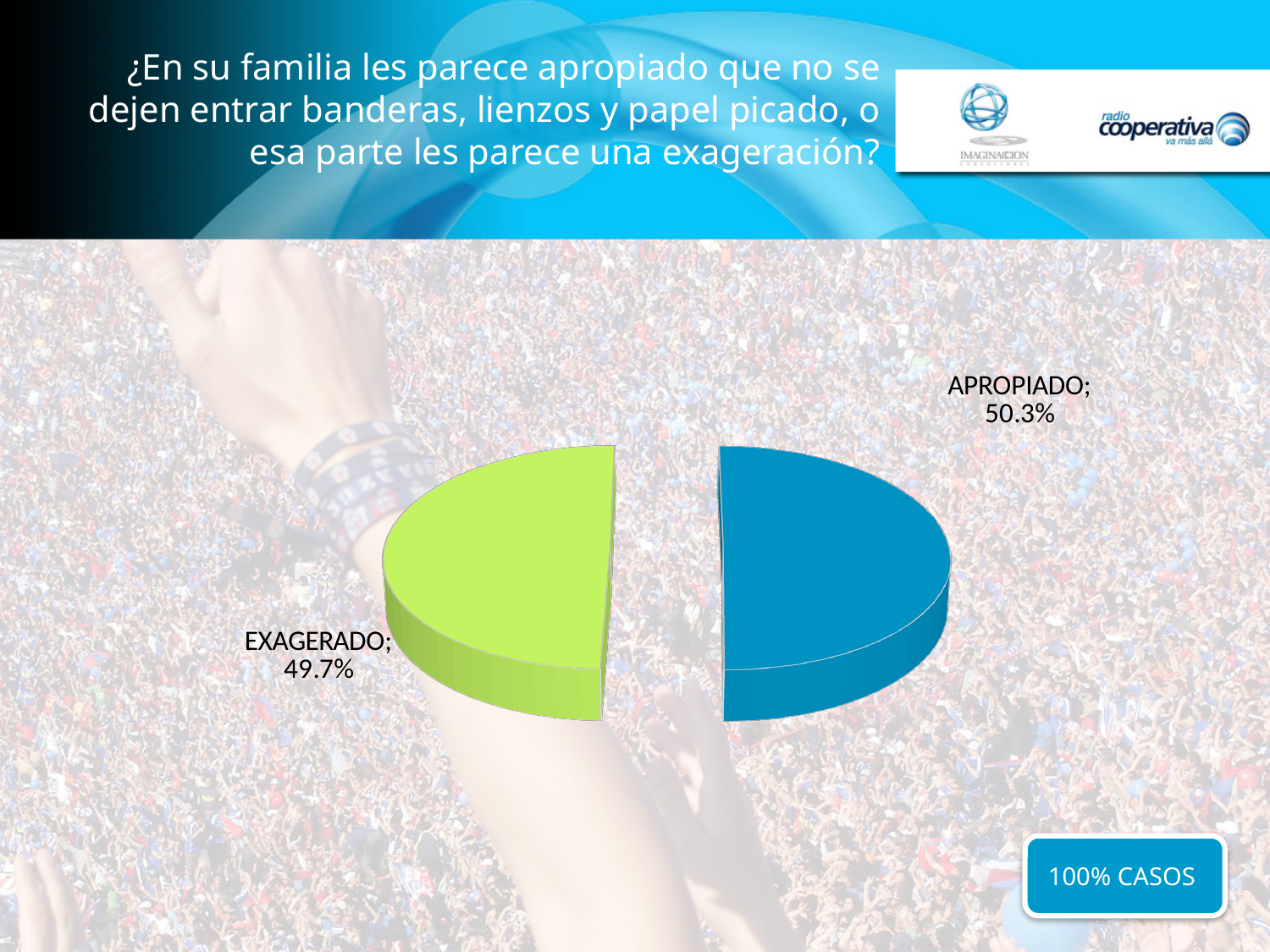
What percentage of the pie chart is labelled EXAGERADO? 49.7% What colour is the EXAGERADO slice of the pie chart? Green What colour is the APROPIADO slice of the pie chart? Blue Which category has the highest share in the pie chart? APROPIADO Which slice of the pie chart has the larger share, APROPIADO or EXAGERADO? APROPIADO Is the share for EXAGERADO greater or less than 50%? less Is the share for APROPIADO greater or less than 50%? greater Which category has the lowest share in the pie chart? EXAGERADO What is the difference in percentage points between the APROPIADO and EXAGERADO slices? 0.6% What kind of chart is shown on the slide? Pie chart How many slices does the pie chart have? 2 What percentage of the pie chart is labelled APROPIADO? 50.3%